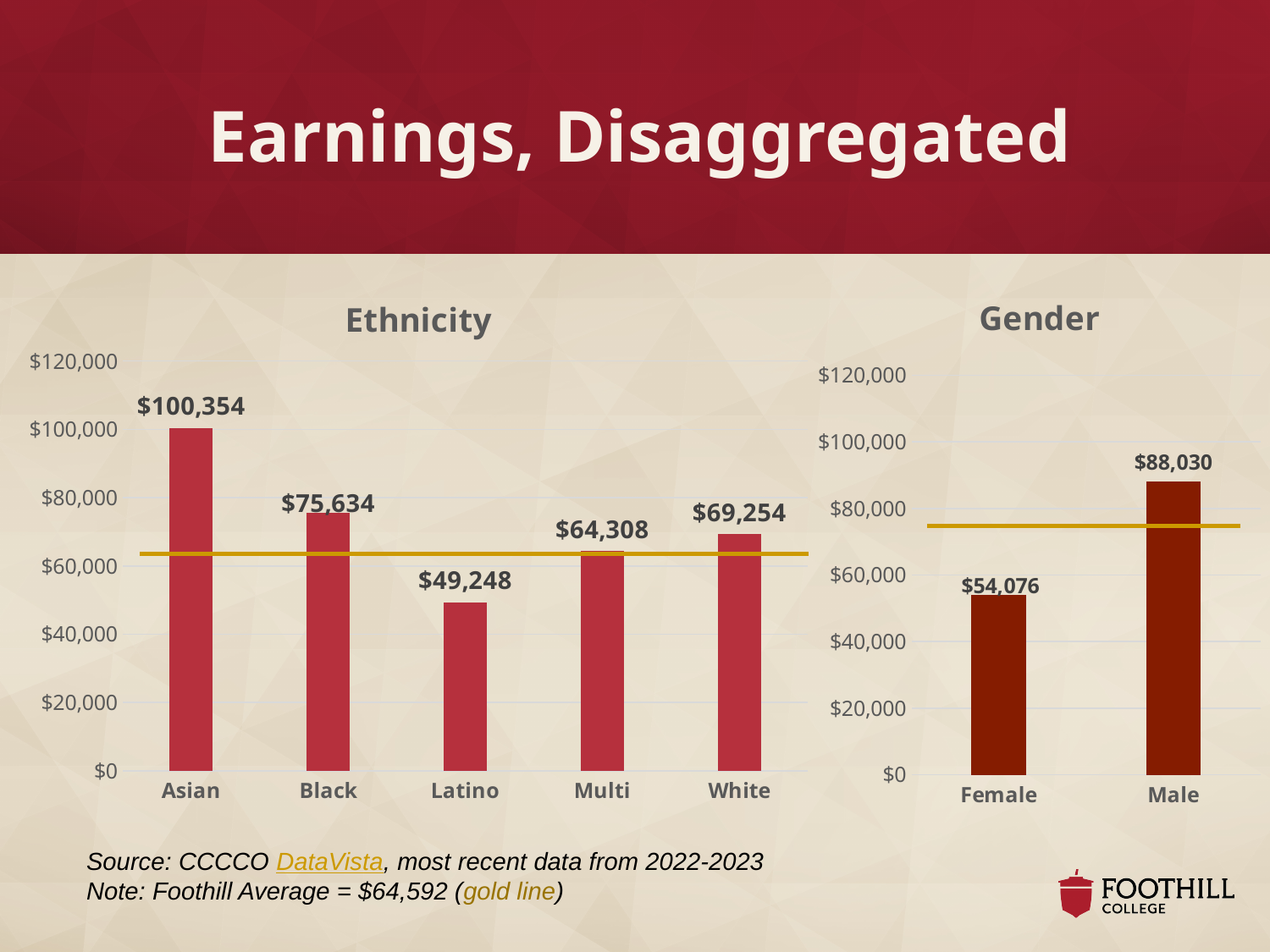
In the Ethnicity chart, which category has the highest earnings? Asian In the Ethnicity chart, what are the earnings for Asian? $100,354 How many categories are shown in the Ethnicity chart? 5 In the Gender chart, what are the earnings for Female? $54,076 In the Ethnicity chart, what is the difference between Black and Multi earnings? $11,326 In the Gender chart, what is the difference between Male and Female earnings? $33,954 According to the note on the slide, what value does the gold line represent? $64,592 What kind of chart is the Gender chart? bar chart In the Ethnicity chart, is the value for Black greater or less than $80,000? less In the Ethnicity chart, what are the earnings for Latino? $49,248 In the Ethnicity chart, which is larger, the value for White or the value for Multi? White In the Ethnicity chart, which category has the lowest earnings? Latino